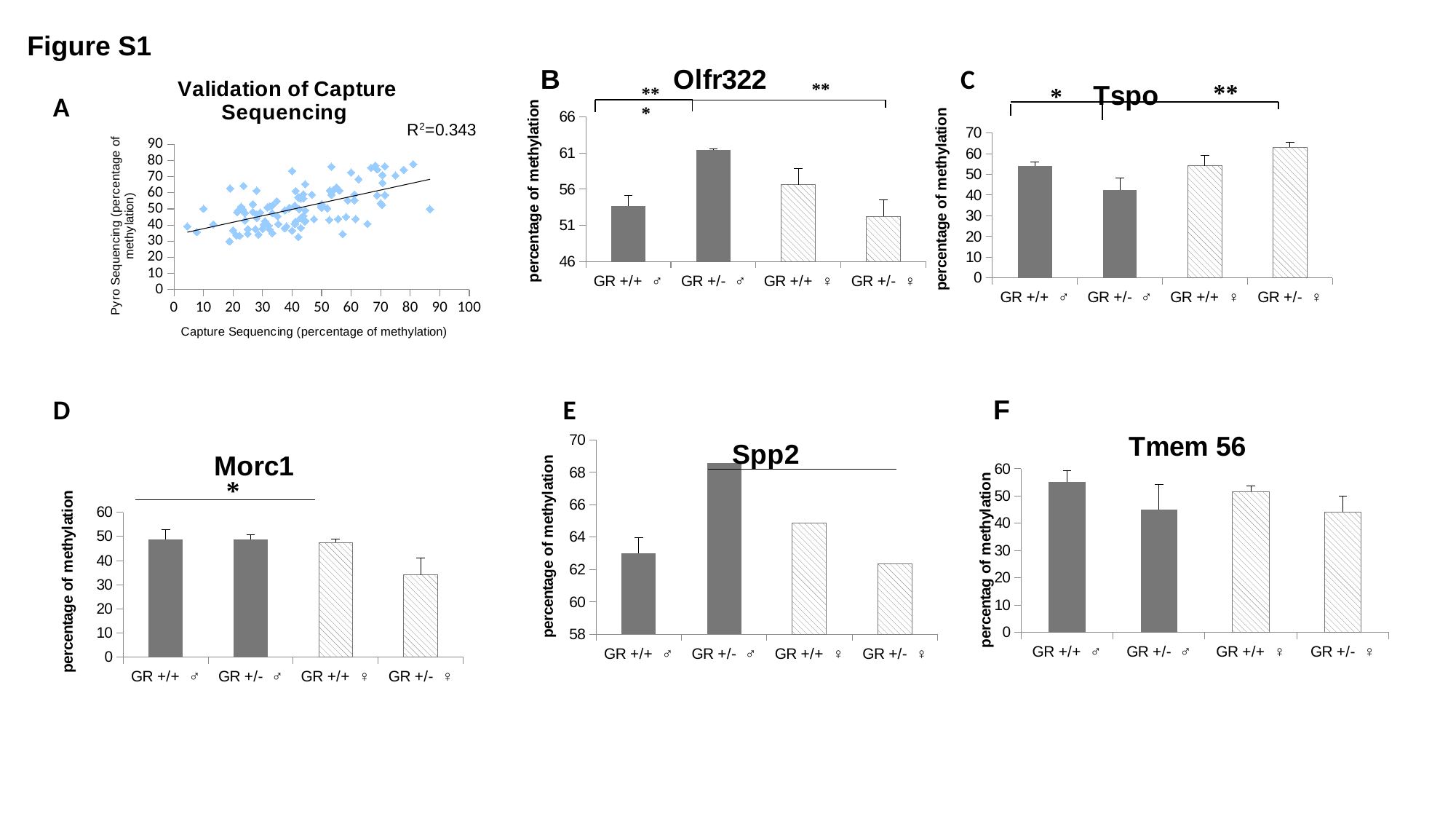
What kind of chart is chart B, 'Olfr322'? bar chart In chart C, 'Tspo', which group has the lowest percentage of methylation? GR +/- ♂ In chart B, 'Olfr322', which group has the highest percentage of methylation? GR +/- ♂ In chart D, 'Morc1', which group has the lowest percentage of methylation? GR +/- ♀ In chart D, 'Morc1', how many groups are plotted on the x axis? 4 In chart B, 'Olfr322', is the value for GR +/- ♂ greater or less than 56? greater In chart C, 'Tspo', is the value for GR +/- ♂ greater or less than 50? less In chart A, 'Validation of Capture Sequencing', what R² value is shown? R²=0.343 In chart F, 'Tmem 56', which is larger, the value for GR +/+ ♂ or GR +/- ♂? GR +/+ ♂ In chart E, 'Spp2', is the value for GR +/- ♂ greater or less than 66? greater In chart C, 'Tspo', which group has the highest percentage of methylation? GR +/- ♀ What kind of chart is chart A, 'Validation of Capture Sequencing'? scatter plot